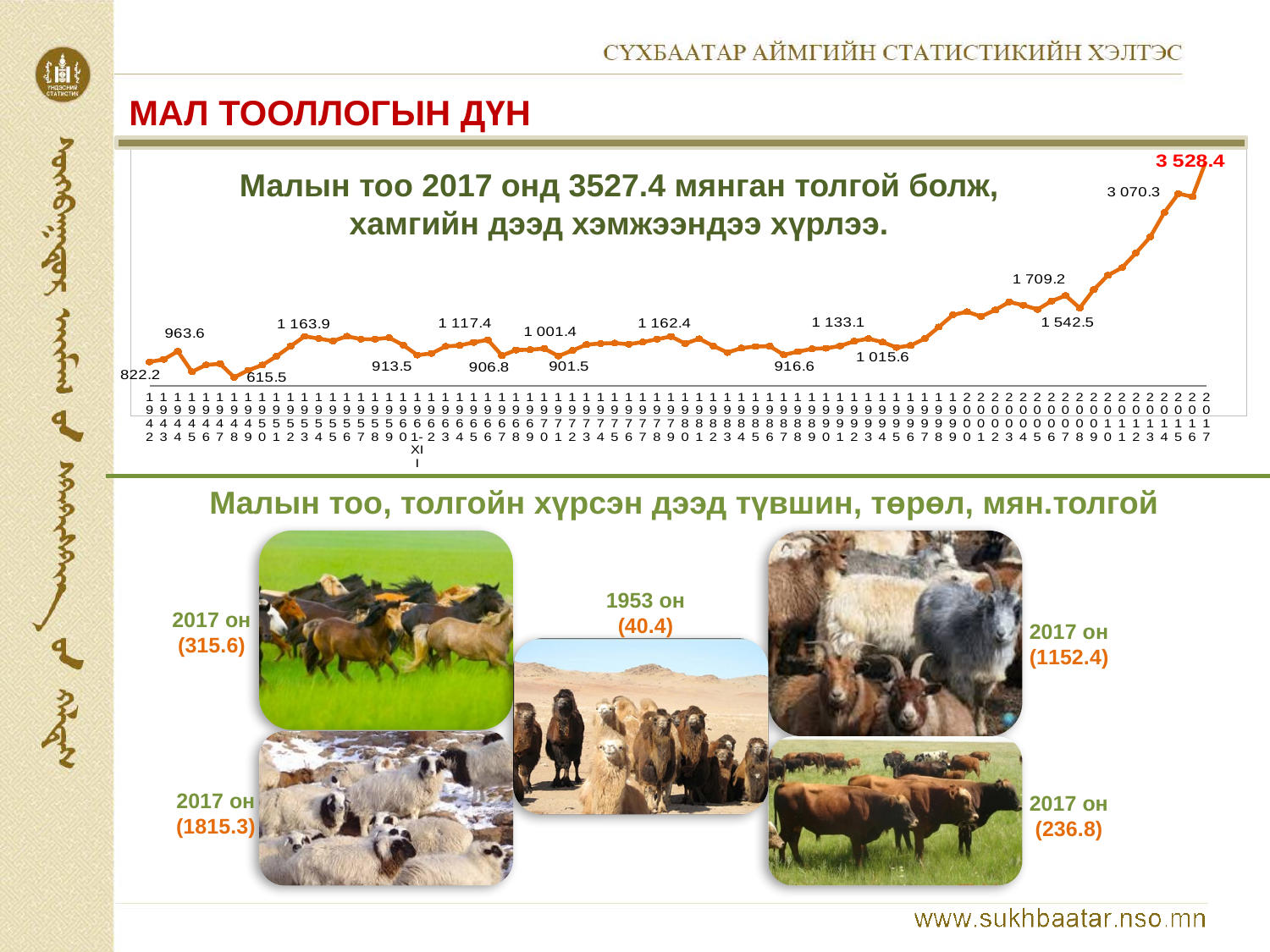
How many data series are plotted on the line chart? 1 What is the highest value labelled on the line chart? 3 528.4 Overall, does the line rise or fall from 1942 to 2017? rise What is the value of the last point on the line chart, for 2017? 3 528.4 What is the lowest value labelled on the line chart? 615.5 What is the second-highest value labelled on the line chart? 3 070.3 Which labelled value is larger: 1 163.9 or 1 117.4? 1 163.9 What is the difference between the highest labelled value (3 528.4) and the second-highest (3 070.3)? 458.1 What is the value of the first point on the line chart, for 1942? 822.2 Which labelled value is larger: 1 709.2 or 1 542.5? 1 709.2 What kind of chart is shown on the slide? line chart What is the difference between the 2017 value (3 528.4) and the 1942 value (822.2)? 2 706.2